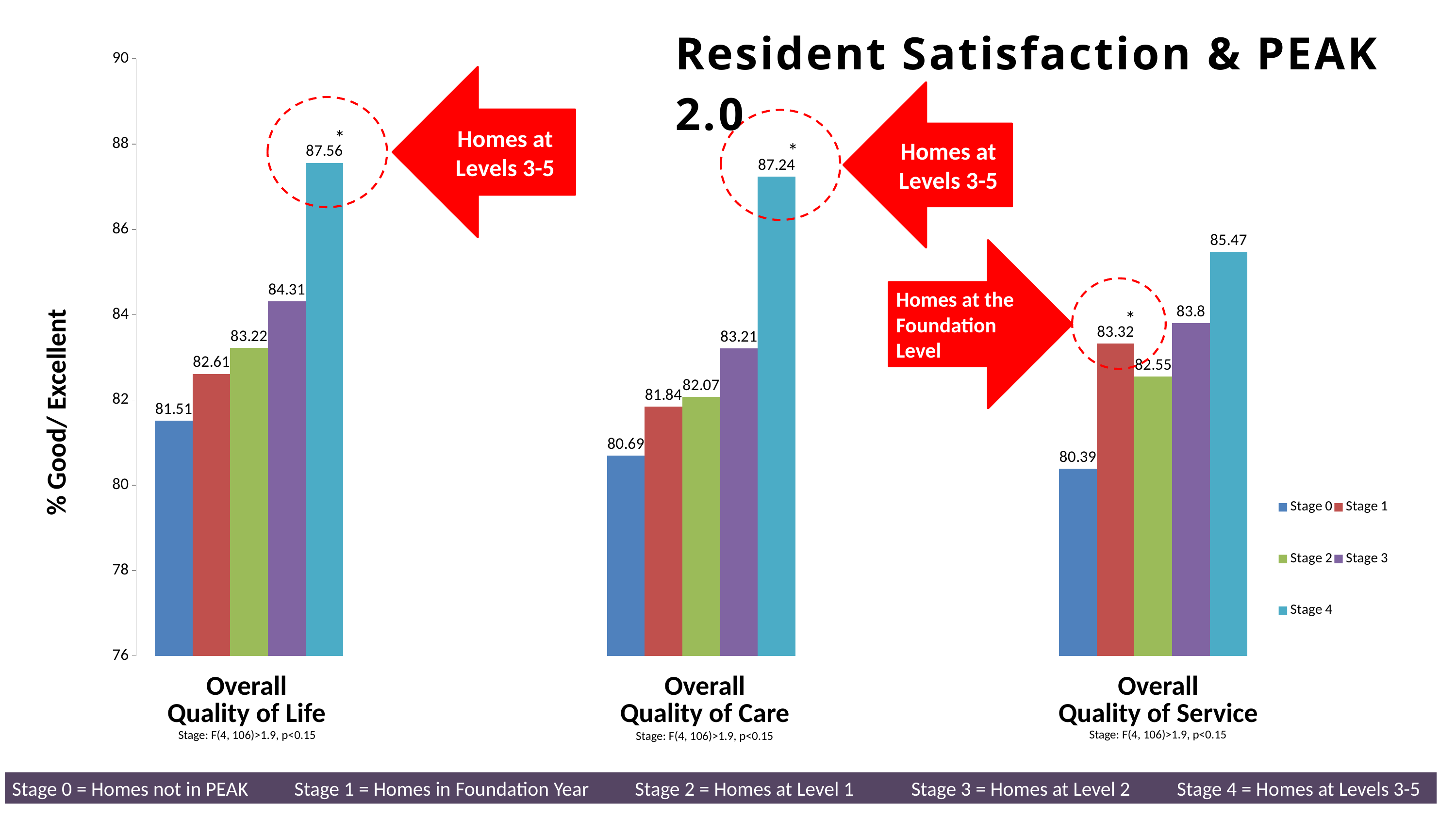
Which stage has the highest value in the Overall Quality of Care category? Stage 4 Which stage has the lowest value in the Overall Quality of Service category? Stage 0 How many series does the legend list? 5 What is the value for Stage 4 in the Overall Quality of Life category? 87.56 What is the value for Stage 3 in the Overall Quality of Service category? 83.8 What is the value for Stage 1 in the Overall Quality of Service category? 83.32 How many categories are shown on the x axis? 3 What is the value for Stage 0 in the Overall Quality of Care category? 80.69 What kind of chart is shown on the slide? Bar chart What is the difference between the Stage 1 and Stage 2 values in the Overall Quality of Service category? 0.77 What is the difference between the Stage 4 and Stage 0 values in the Overall Quality of Life category? 6.05 In the Overall Quality of Service category, which is larger: the Stage 1 value or the Stage 2 value? Stage 1